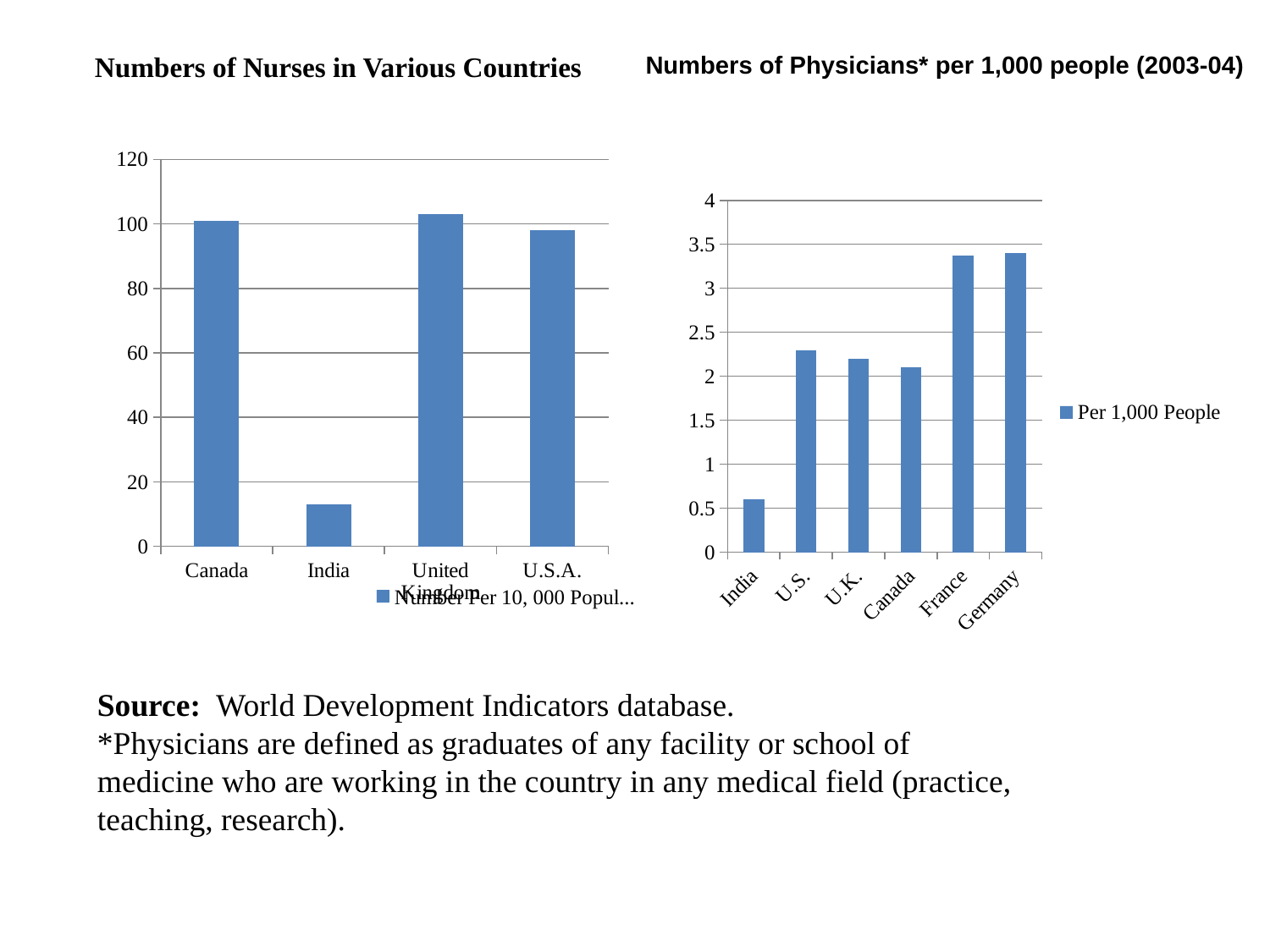
In the 'Numbers of Nurses in Various Countries' chart, is the value for India greater or less than 20? less In the 'Numbers of Physicians* per 1,000 people (2003-04)' chart, which is larger, the value for Canada or the value for Germany? Germany In the 'Numbers of Physicians* per 1,000 people (2003-04)' chart, is the value for France greater or less than 3? greater In the 'Numbers of Nurses in Various Countries' chart, which is larger, the value for India or the value for U.S.A.? U.S.A. In the 'Numbers of Physicians* per 1,000 people (2003-04)' chart, is the value for India greater or less than 1? less In the 'Numbers of Physicians* per 1,000 people (2003-04)' chart, how many countries are shown? 6 What is the legend entry in the 'Numbers of Physicians* per 1,000 people (2003-04)' chart? Per 1,000 People In the 'Numbers of Nurses in Various Countries' chart, how many countries are shown? 4 What type of chart is 'Numbers of Physicians* per 1,000 people (2003-04)'? bar chart In the 'Numbers of Nurses in Various Countries' chart, which country has the lowest value? India In the 'Numbers of Physicians* per 1,000 people (2003-04)' chart, which country has the lowest value? India